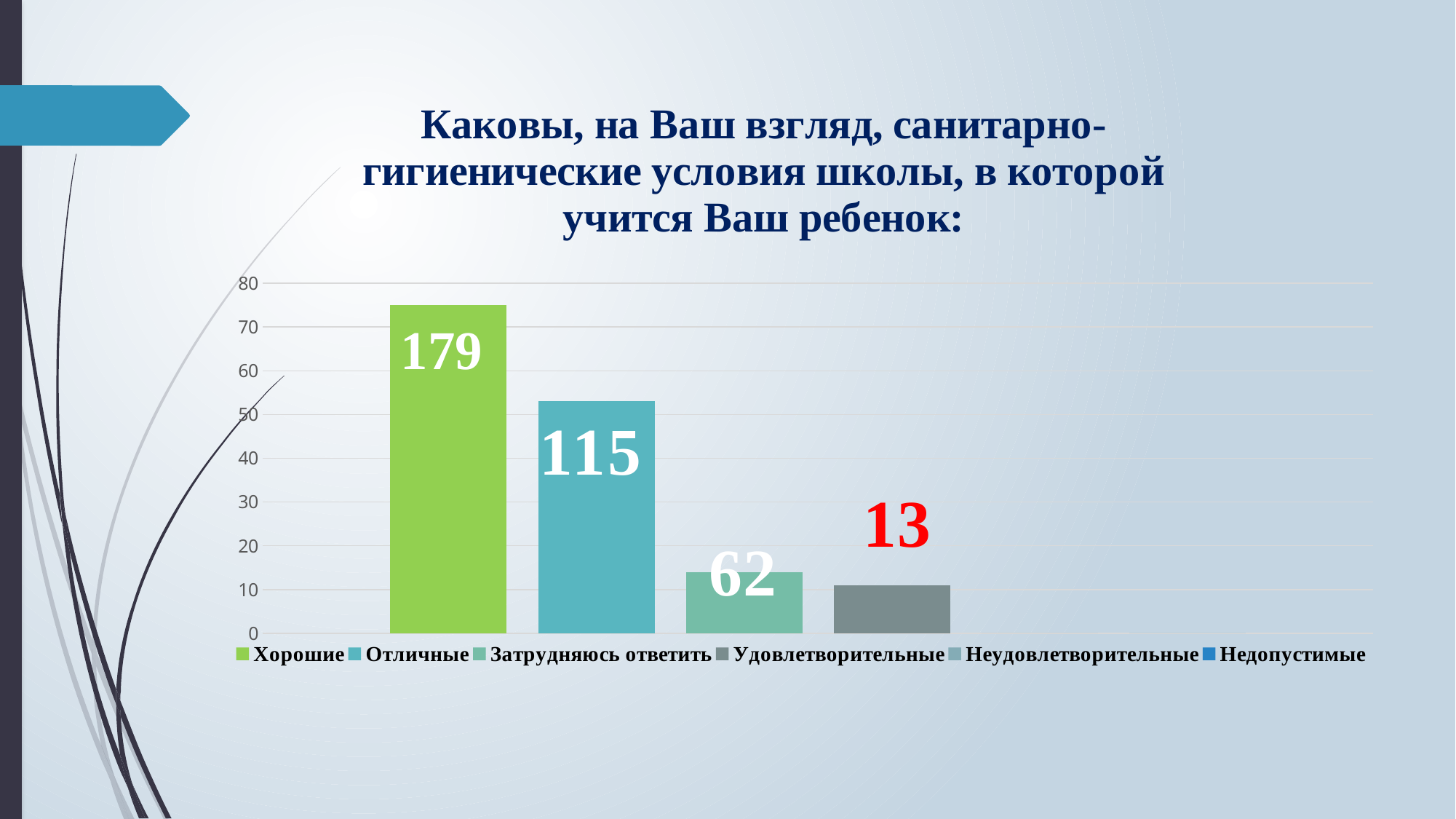
How many bars are plotted in the chart? 4 What value is labelled on the bar for Отличные? 115 Which of the plotted categories has the shortest bar? Удовлетворительные Which category has the tallest bar? Хорошие What value is labelled on the bar for Хорошие? 179 How many entries does the legend list? 6 What is the difference between the labelled values for Хорошие and Отличные? 64 Do the bar values rise or fall from left to right? fall What value is labelled on the bar for Затрудняюсь ответить? 62 What type of chart is shown on the slide? bar chart What value is labelled for Удовлетворительные? 13 Which is larger, the value for Отличные or the value for Затрудняюсь ответить? Отличные